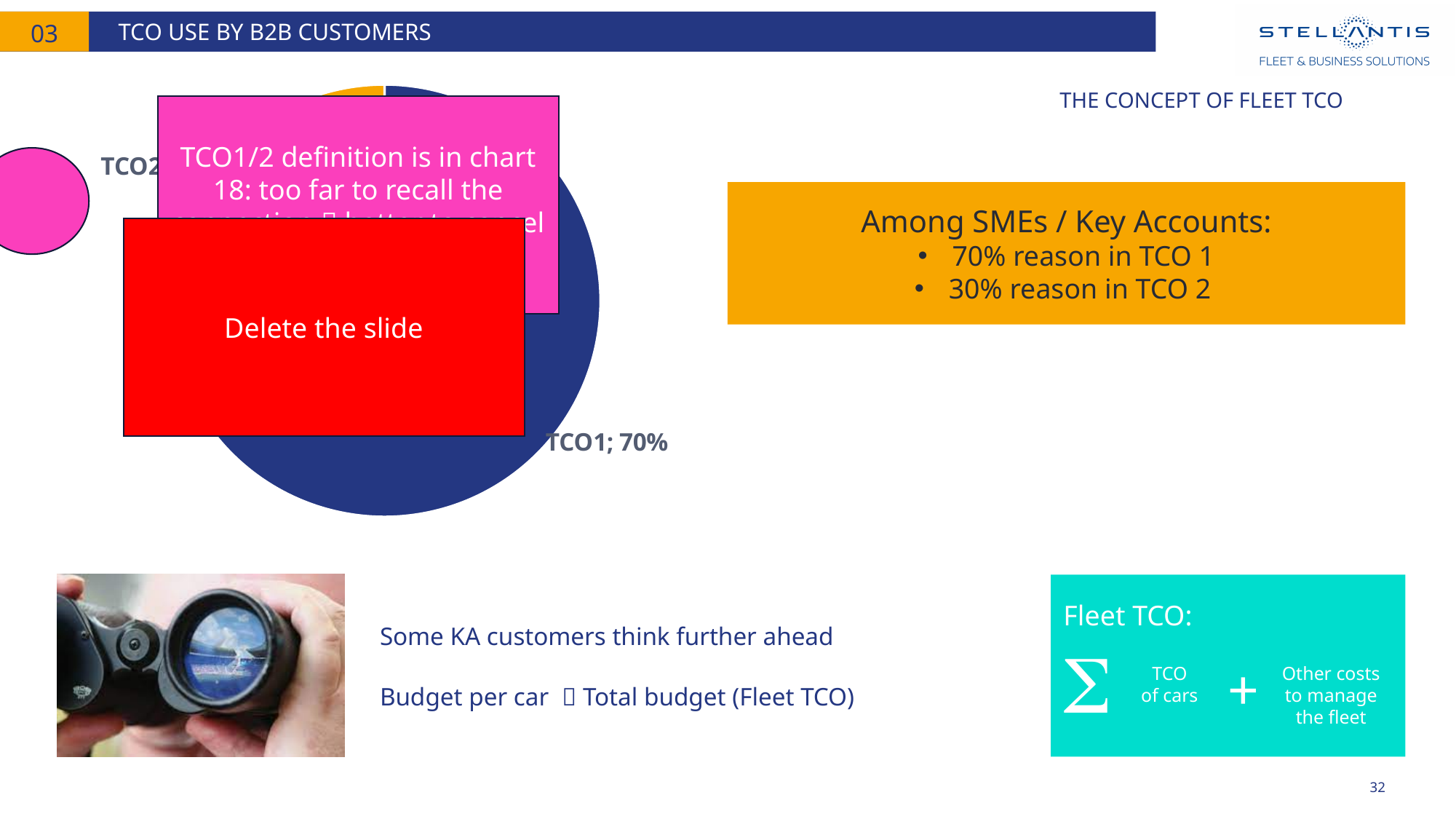
What colour is the TCO2 slice of the pie chart? orange What share of the pie does TCO1 represent? 70% Which slice of the pie chart is the largest? TCO1 What kind of chart is shown on the slide? pie chart What colour is the TCO1 slice of the pie chart? dark blue What is the value shown for TCO1 in the pie chart? 70% Is the value for TCO1 in the pie chart greater or less than 50%? greater Which slice of the pie chart is the smallest? TCO2 Which is larger in the pie chart, TCO1 or TCO2? TCO1 How many slices does the pie chart have? 2